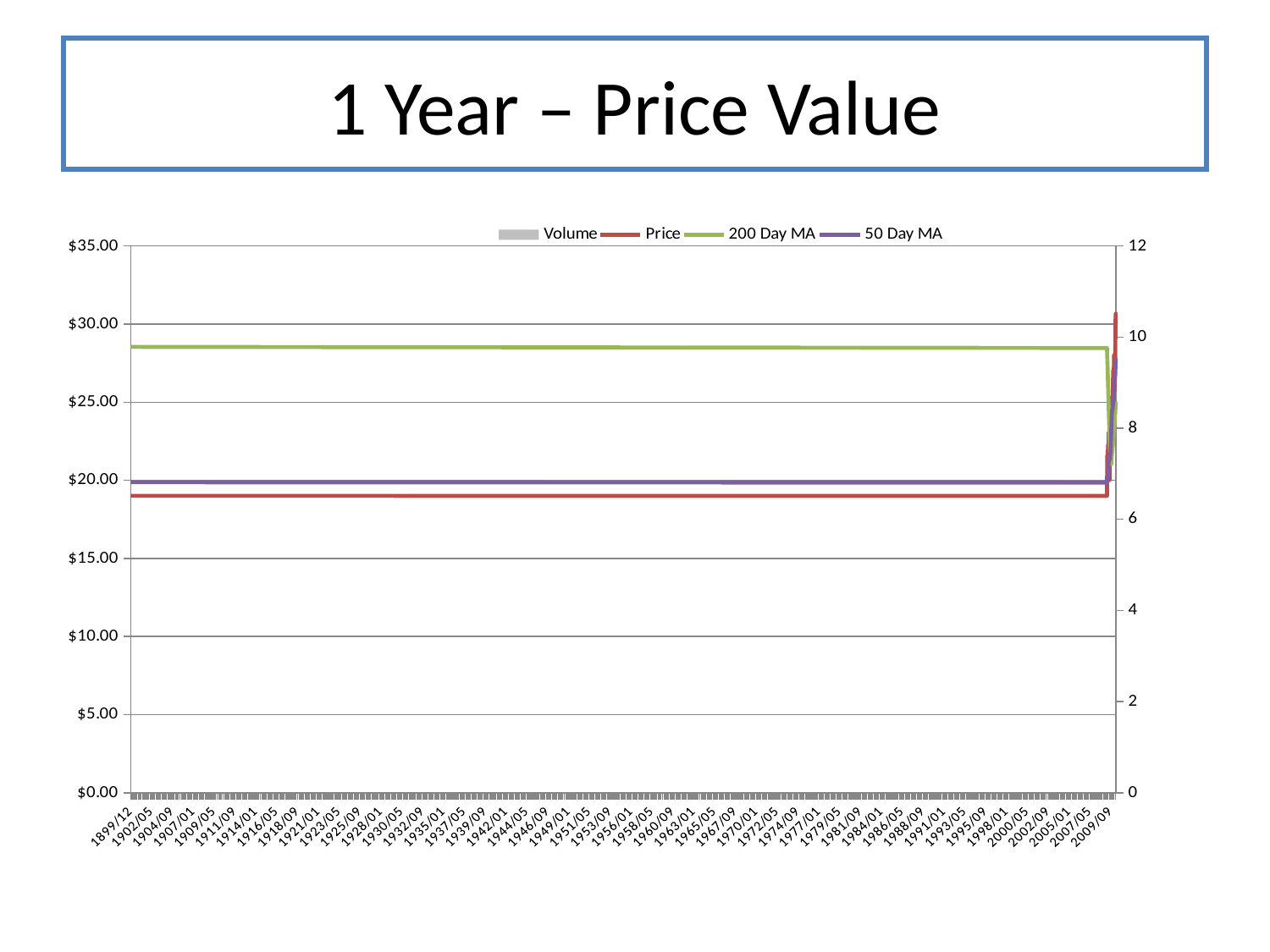
Is the value of the Price line for most of the chart greater or less than $15.00? greater What is the title of the chart slide? 1 Year – Price Value For most of the chart, which is larger, the 200 Day MA or the 50 Day MA? 200 Day MA Is the value of the 200 Day MA line for most of the chart greater or less than $25.00? greater What is the maximum value shown on the left vertical axis? $35.00 Does the Price line rise or fall at the far right end of the x axis? rise How many series does the chart legend list? 4 What are the series names listed in the chart legend? Volume, Price, 200 Day MA, 50 Day MA Which line series sits lowest on the chart for most of the x axis? Price Which line series sits highest on the chart for most of the x axis? 200 Day MA What kind of chart is shown on the slide? combination bar and line chart Is the value of the Price line for most of the chart greater or less than $20.00? less